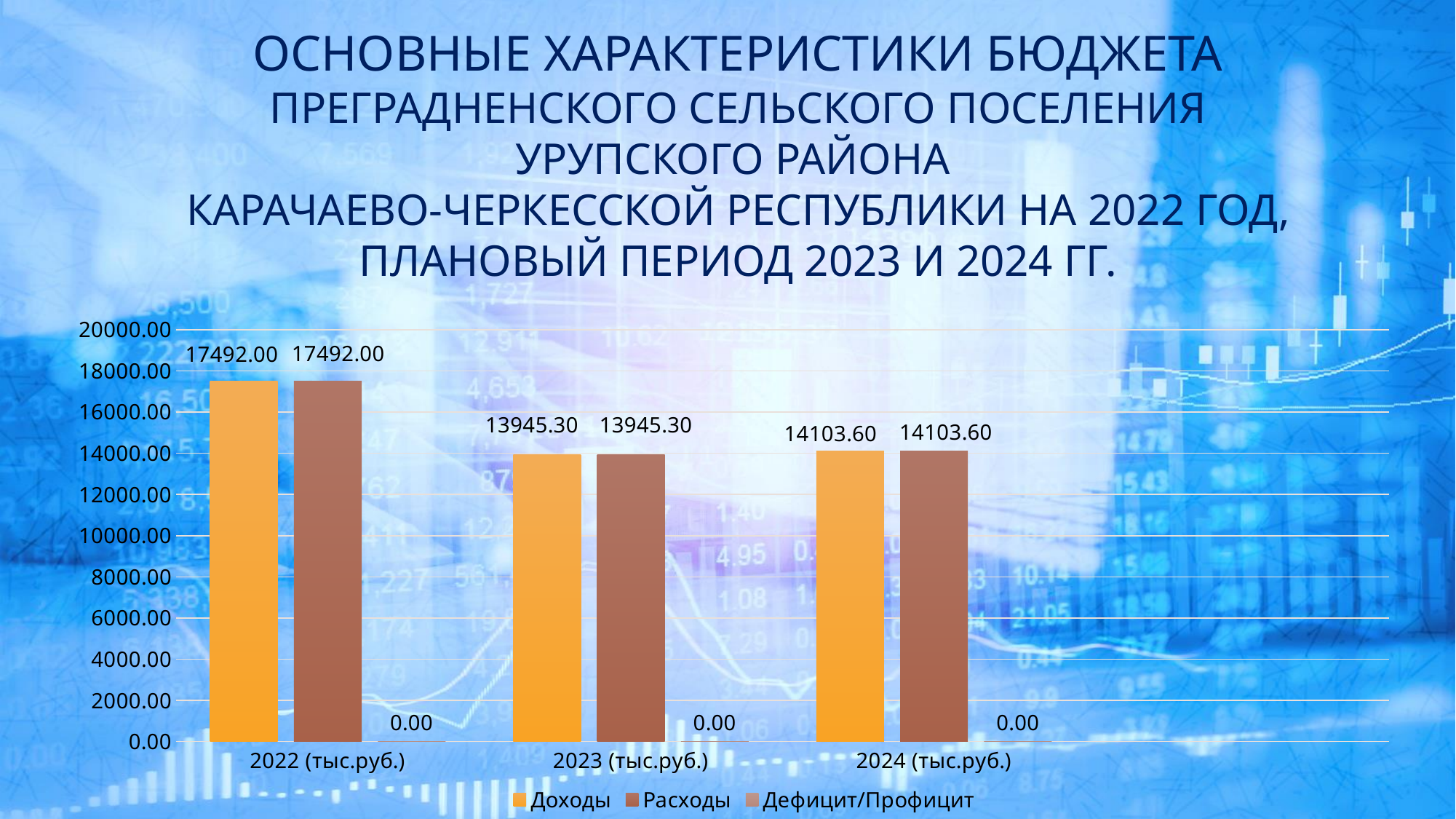
What is the difference between Доходы in 2022 and Доходы in 2023? 3546.70 What is the value of Дефицит/Профицит for 2023 (тыс.руб.)? 0.00 What is the value of Доходы for 2022 (тыс.руб.)? 17492.00 How many year categories are shown on the x axis? 3 In which year is Расходы the lowest? 2023 (тыс.руб.) What kind of chart is shown on the slide? bar chart What is the value of Доходы for 2024 (тыс.руб.)? 14103.60 How many series does the legend list? 3 Which is larger: Расходы in 2024 or Расходы in 2023? Расходы in 2024 In which year is Доходы the highest? 2022 (тыс.руб.) What is the value of Расходы for 2023 (тыс.руб.)? 13945.30 Which series is shown in orange in the legend? Доходы